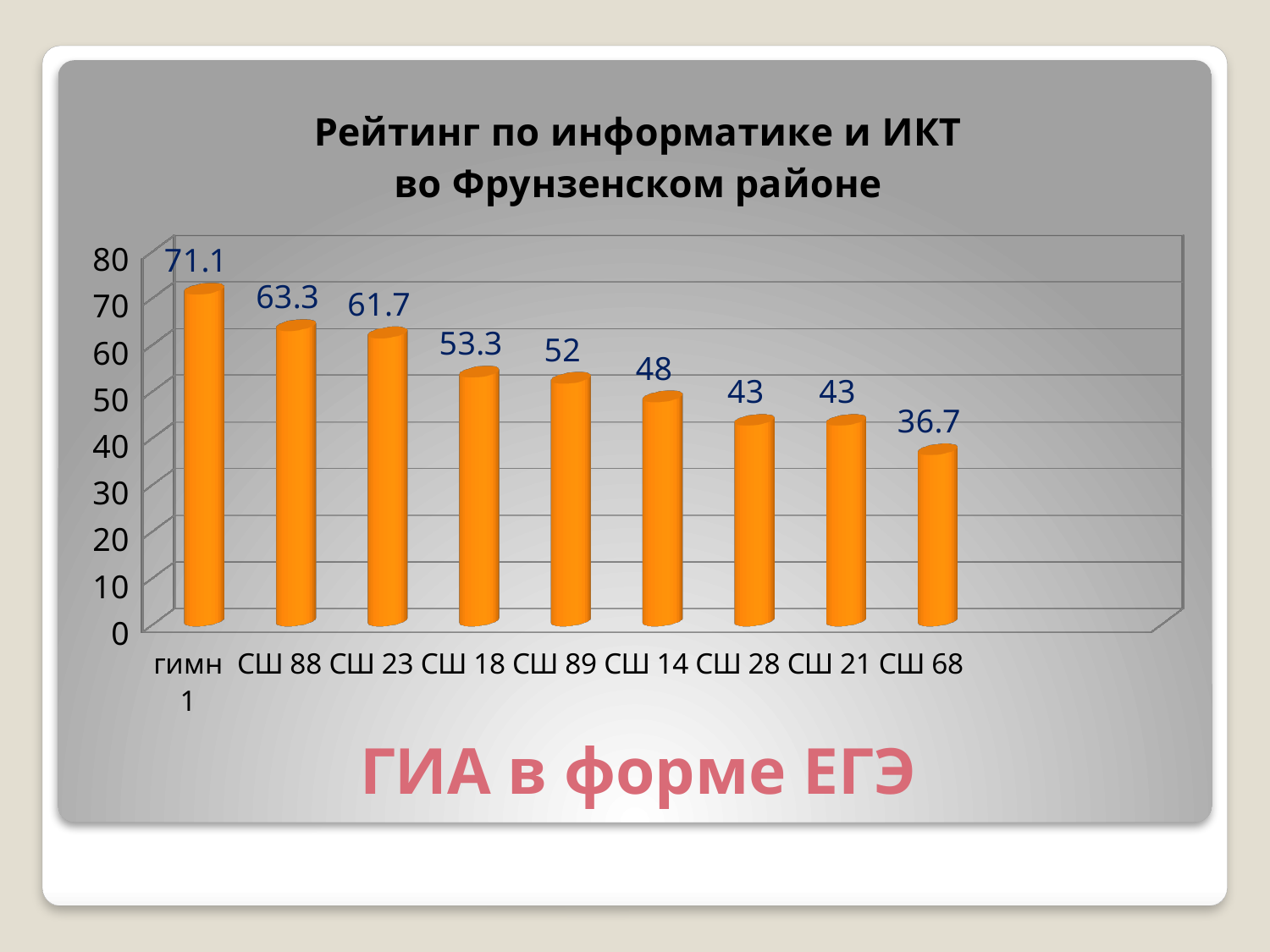
What is the value for СШ 18? 53.3 What kind of chart is shown on the slide? bar chart What is the value for СШ 14? 48 What is the difference between the values for гимн 1 and СШ 68? 34.4 Which category has the lowest value? СШ 68 How many categories are shown on the x axis? 9 Do the values rise or fall from left to right along the x axis? fall Is the value for СШ 28 greater or less than 50? less What is the value for СШ 88? 63.3 Which is larger, the value for СШ 88 or the value for СШ 18? СШ 88 What is the difference between the values for СШ 23 and СШ 89? 9.7 Which category has the highest value? гимн 1